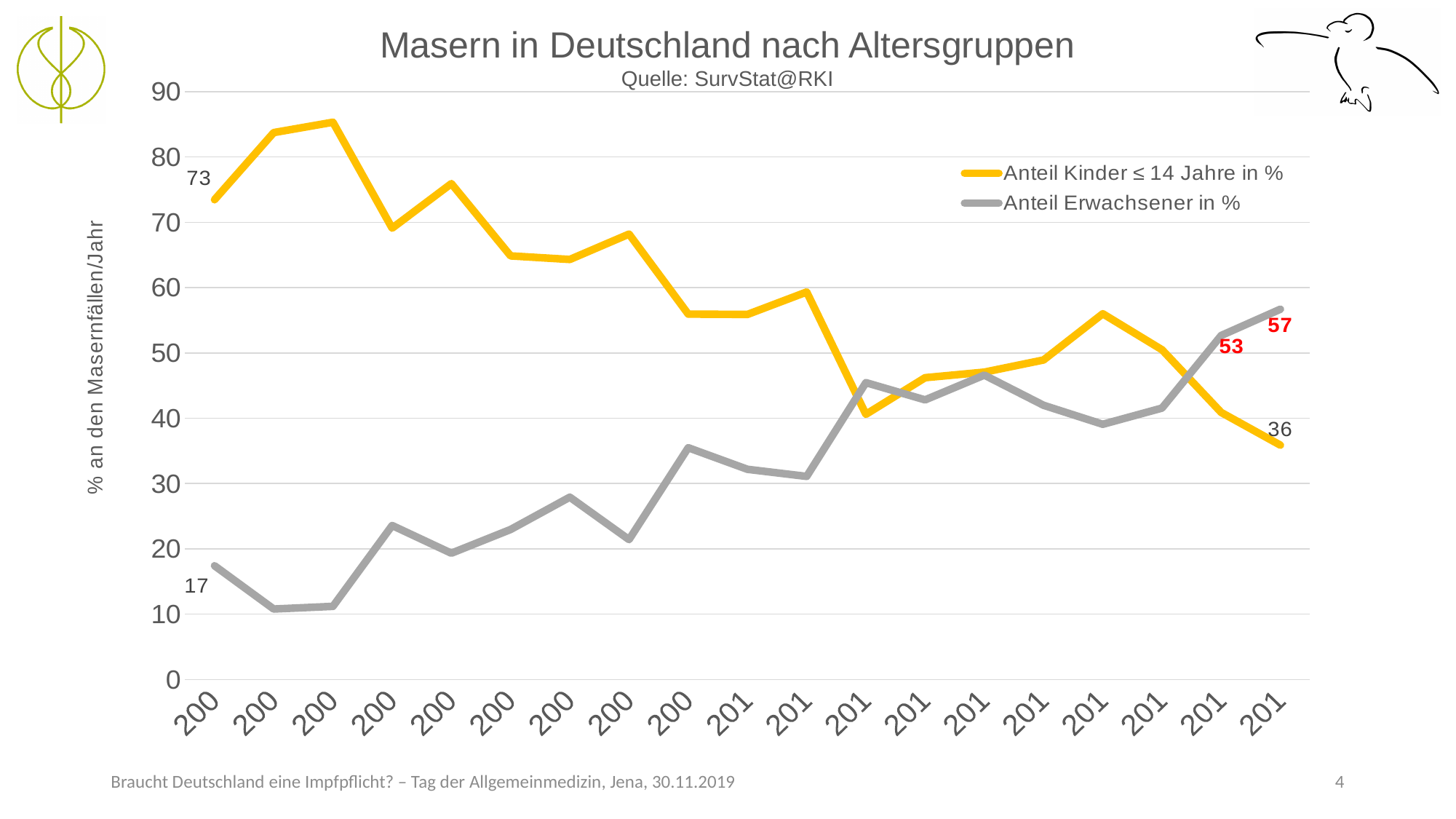
By how much does 'Anteil Kinder ≤ 14 Jahre in %' fall from the first point (73) to the last point (36)? 37 Is the value of 'Anteil Kinder ≤ 14 Jahre in %' at the third point on the x axis greater or less than 80? greater What is the value of 'Anteil Erwachsener in %' at the first point on the x axis? 17 How many series does the legend list? 2 What is the value of 'Anteil Kinder ≤ 14 Jahre in %' at the last point on the x axis? 36 What is the difference between 'Anteil Erwachsener in %' (57) and 'Anteil Kinder ≤ 14 Jahre in %' (36) at the last point on the x axis? 21 At the first point on the x axis, which series has the larger value: 'Anteil Kinder ≤ 14 Jahre in %' or 'Anteil Erwachsener in %'? Anteil Kinder ≤ 14 Jahre in % What is the value of 'Anteil Kinder ≤ 14 Jahre in %' at the first point on the x axis? 73 What kind of chart is shown on the slide? line chart What is the title of the chart? Masern in Deutschland nach Altersgruppen What is the value of 'Anteil Erwachsener in %' at the last point on the x axis? 57 Does 'Anteil Erwachsener in %' generally rise or fall along the x axis? rise